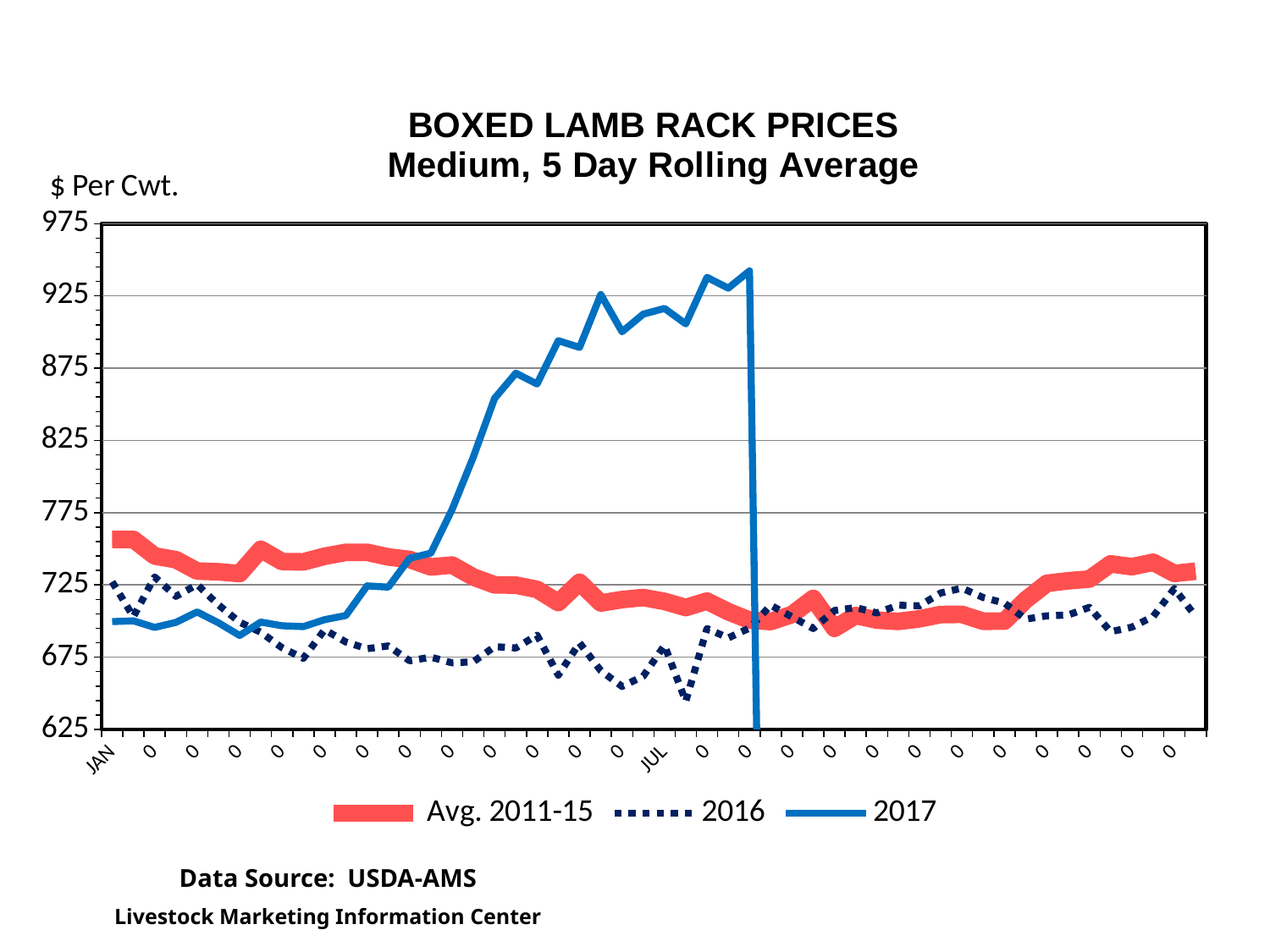
Is the lowest value of the 2016 series greater or less than 675? less How many series does the legend list? 3 Which series reaches the highest value on the chart? 2017 What unit is shown on the vertical axis? $ Per Cwt. What are the three series listed in the legend? Avg. 2011-15, 2016, 2017 What kind of chart is shown on the slide? line chart Is the value of the 2017 series at JAN greater or less than 725? less Around JUL, which series is higher: 2017 or Avg. 2011-15? 2017 Is the peak value of the 2017 series greater or less than 925? greater Does the 2017 series rise or fall between JAN and JUL? rise Around JUL, which series is lower: 2016 or Avg. 2011-15? 2016